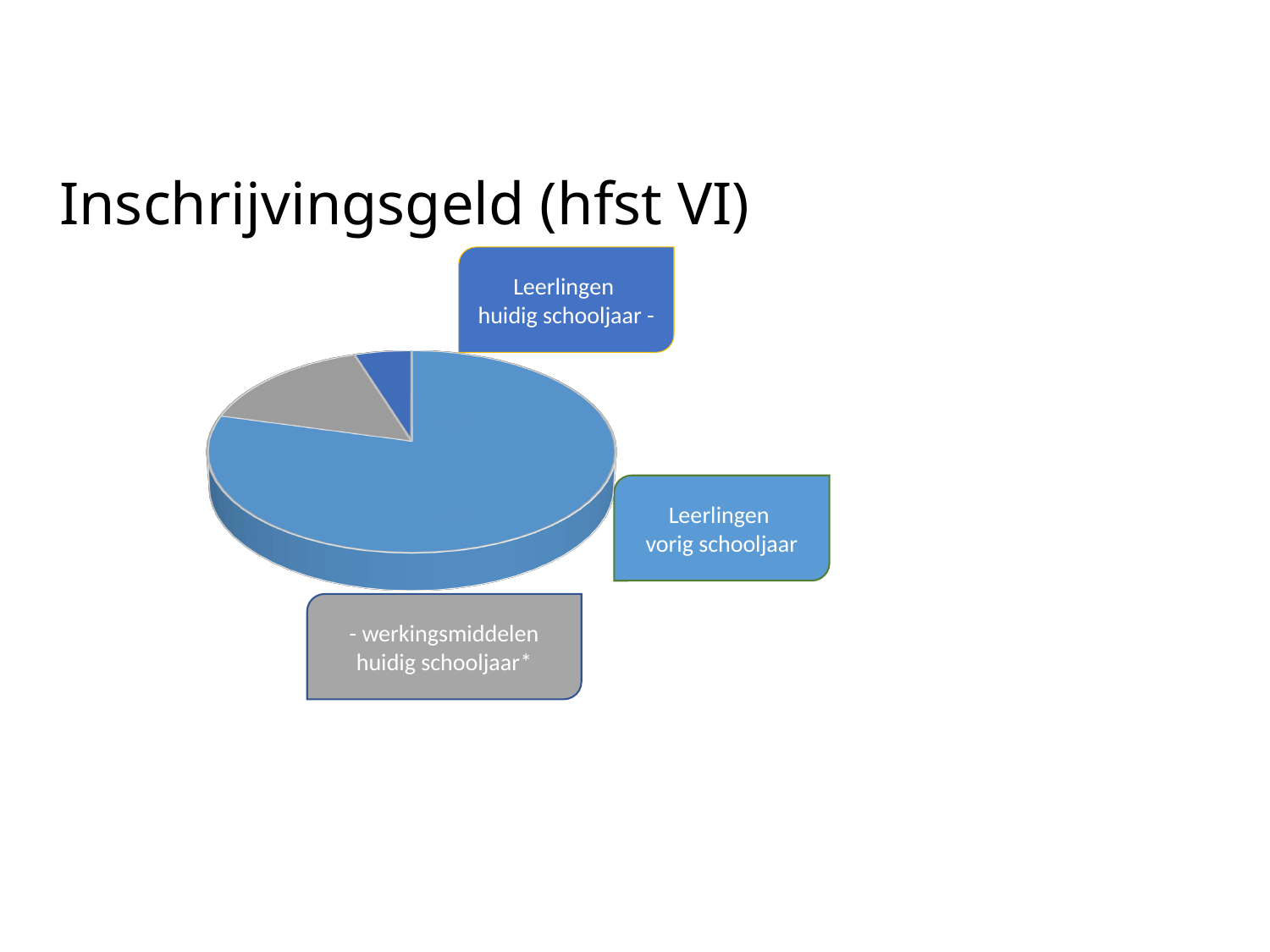
What kind of chart is shown on the slide? pie chart What colour is the slice labelled '- werkingsmiddelen huidig schooljaar*'? gray How many slices does the pie chart have? 3 Which slice of the pie chart is the largest? Leerlingen vorig schooljaar Which slice is larger: '- werkingsmiddelen huidig schooljaar*' or 'Leerlingen huidig schooljaar -'? - werkingsmiddelen huidig schooljaar* Which slice of the pie chart is the smallest? Leerlingen huidig schooljaar - Which slice is larger: 'Leerlingen vorig schooljaar' or '- werkingsmiddelen huidig schooljaar*'? Leerlingen vorig schooljaar What is the title of the slide containing the pie chart? Inschrijvingsgeld (hfst VI)